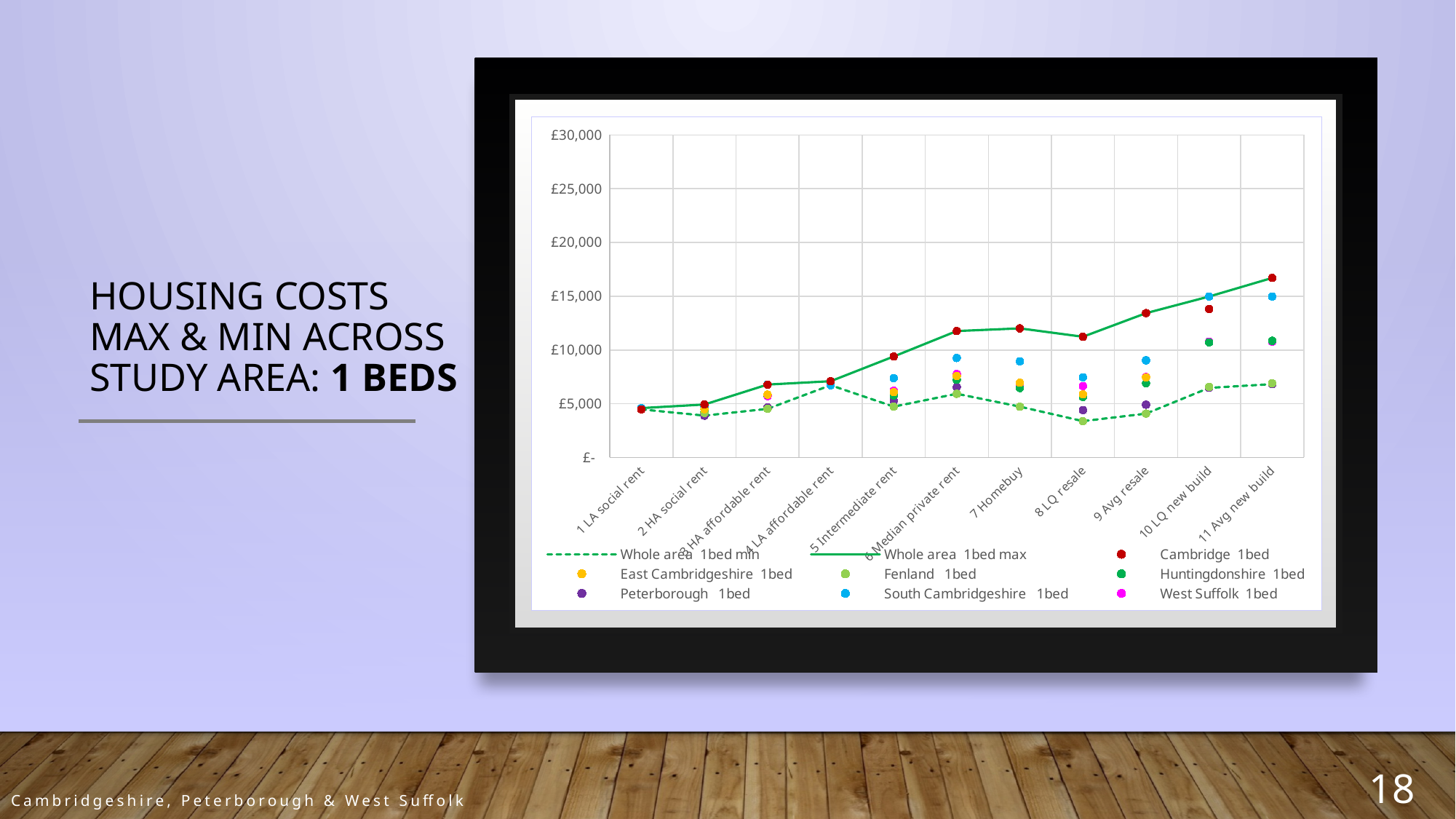
At 11 Avg new build, which is larger: Cambridge 1bed or South Cambridgeshire 1bed? Cambridge 1bed Is the value for Whole area 1bed max at 7 Homebuy greater or less than £10,000? greater What kind of chart is shown on the slide? line chart What colour are the markers for the Cambridge 1bed series? red For Whole area 1bed max, which is larger: the value at 9 Avg resale or at 8 LQ resale? 9 Avg resale Does the Whole area 1bed max line generally rise or fall from 1 LA social rent to 11 Avg new build? rise Is the value for Cambridge 1bed at 11 Avg new build greater or less than £15,000? greater Which category has the highest value for Whole area 1bed max? 11 Avg new build Which category has the lowest value for Whole area 1bed min? 8 LQ resale Is the value for Whole area 1bed min at 8 LQ resale greater or less than £5,000? less How many series does the chart's legend list? 9 How many categories are shown along the x axis of the chart? 11